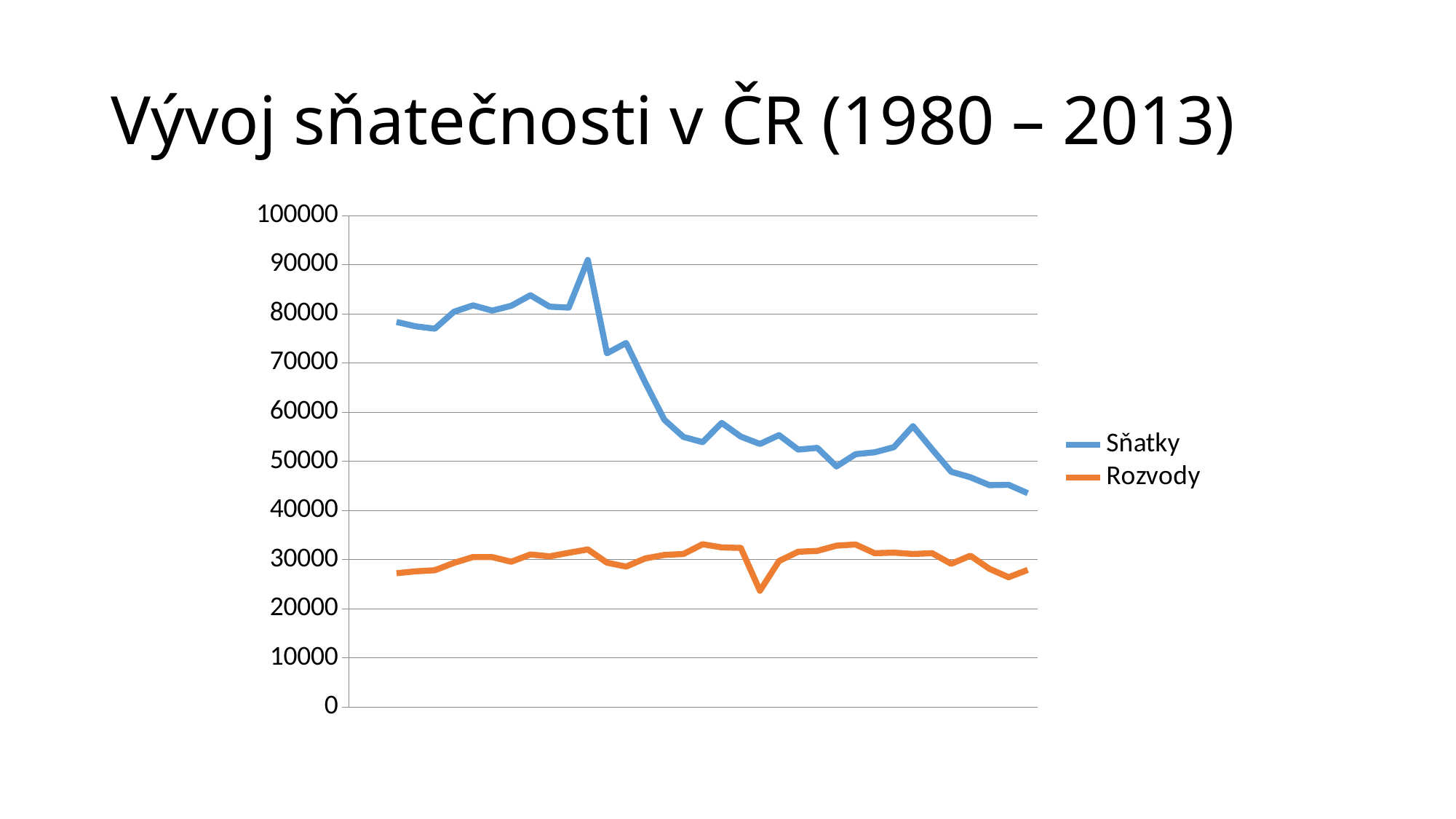
What is the title of the slide containing the chart? Vývoj sňatečnosti v ČR (1980 – 2013) Is the lowest value of the Rozvody series greater or less than 25000? less What are the two series named in the legend? Sňatky and Rozvody Which series has the higher values across the whole chart, Sňatky or Rozvody? Sňatky What kind of chart is shown on the slide? line chart Is the last value of the Sňatky series greater or less than 50000? less Which series reaches the highest value on the chart? Sňatky Is the highest value of the Rozvody series greater or less than 40000? less Overall, do the values of the Sňatky series rise or fall from left to right? fall How many series does the legend list? 2